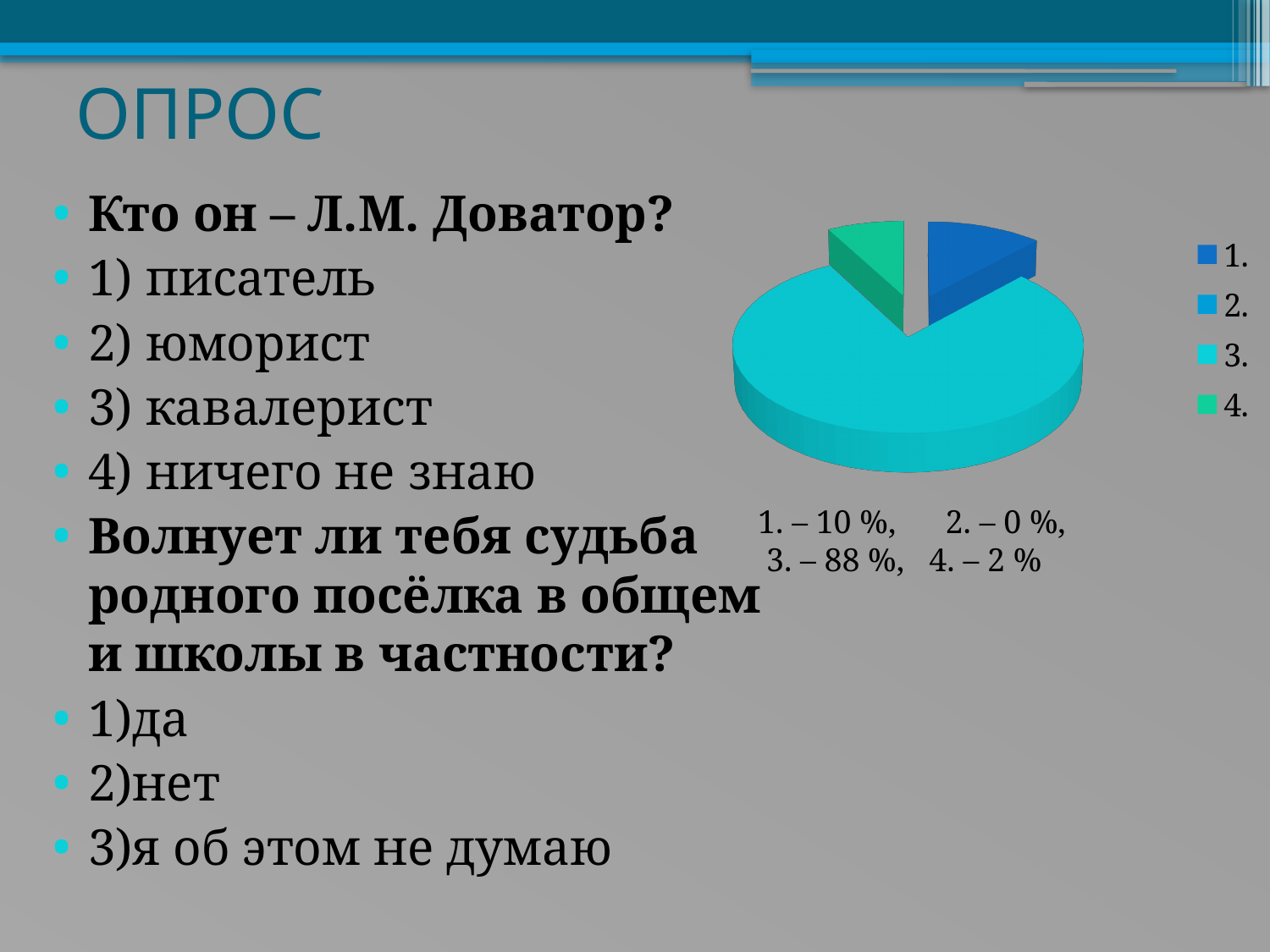
Which category has the largest slice of the pie chart? 3. What colour is the slice for category 4 in the pie chart? green How many entries does the chart legend list? 4 How many slices with a non-zero share does the pie chart show? 3 Which is larger in the pie chart, category 1 or category 4? category 1 Which category has the smallest share in the pie chart? 2. What kind of chart is shown on the slide? pie chart What percentage is given for category 1 in the pie chart? 10 % What percentage is given for category 4 in the pie chart? 2 % What is the difference in percentage points between category 3 and category 1? 78 What percentage is given for category 2 in the pie chart? 0 % What percentage is given for category 3 in the pie chart? 88 %